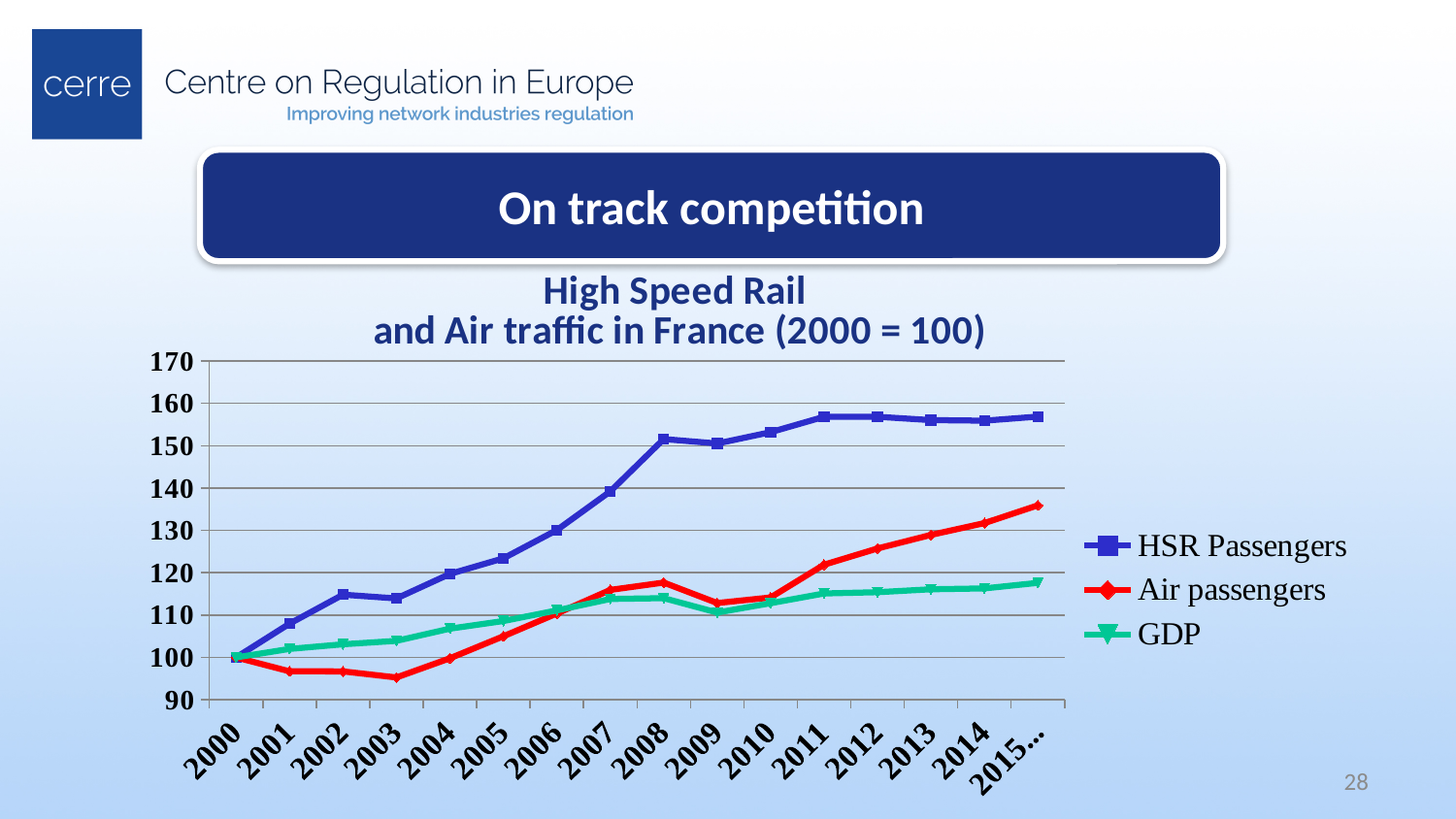
In 2005, which is larger: HSR Passengers or Air passengers? HSR Passengers How many series does the legend list? 3 Is the value for Air passengers in 2003 greater or less than 100? less Is the value for HSR Passengers in 2008 greater or less than 140? greater Which series has the highest value in 2015? HSR Passengers Is the value for HSR Passengers in 2011 greater or less than 150? greater Do the HSR Passengers values rise or fall from 2000 to 2008? rise Which series has the lowest value in 2003? Air passengers How many years are shown along the x axis? 16 What is the value for HSR Passengers in 2000? 100 What type of chart is shown on the slide? Line chart